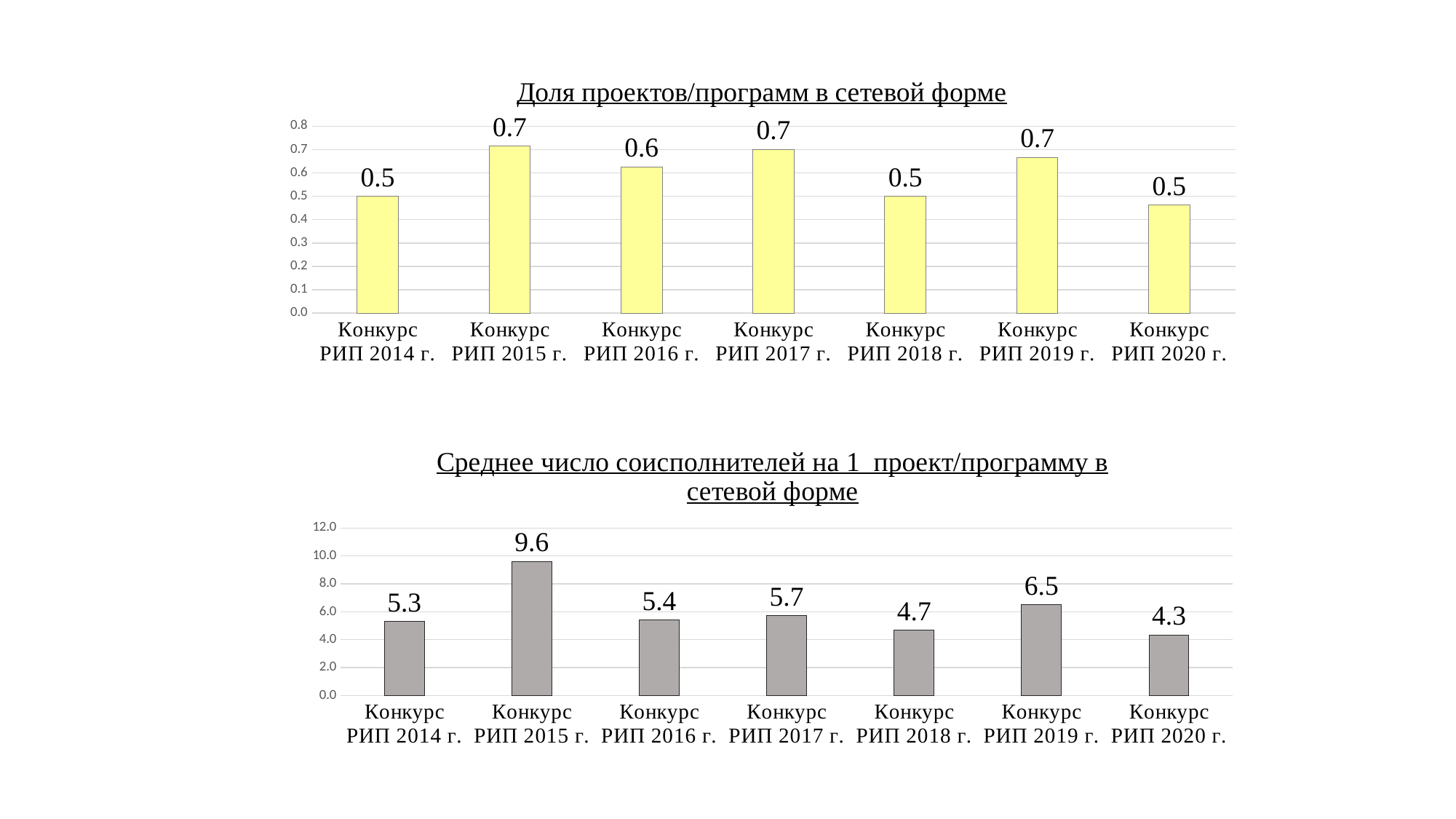
In the bottom chart, is the value for Конкурс РИП 2015 г. greater or less than 8.0? greater In the top chart, how many categories are shown on the x axis? 7 In the chart titled "Доля проектов/программ в сетевой форме", what is the value for Конкурс РИП 2018 г.? 0.5 What colour are the bars in the bottom chart? Grey What kind of chart is the top chart on the slide? Bar chart In the chart titled "Доля проектов/программ в сетевой форме", what is the value for Конкурс РИП 2016 г.? 0.6 In the bottom chart, which category has the highest value? Конкурс РИП 2015 г. In the chart titled "Среднее число соисполнителей на 1 проект/программу в сетевой форме", what is the value for Конкурс РИП 2019 г.? 6.5 In the bottom chart, which is larger: the value for Конкурс РИП 2017 г. or Конкурс РИП 2019 г.? Конкурс РИП 2019 г. In the top chart, what is the difference between the values for Конкурс РИП 2015 г. and Конкурс РИП 2016 г.? 0.1 In the bottom chart, what is the difference between the values for Конкурс РИП 2015 г. and Конкурс РИП 2020 г.? 5.3 In the bottom chart, which category has the lowest value? Конкурс РИП 2020 г.